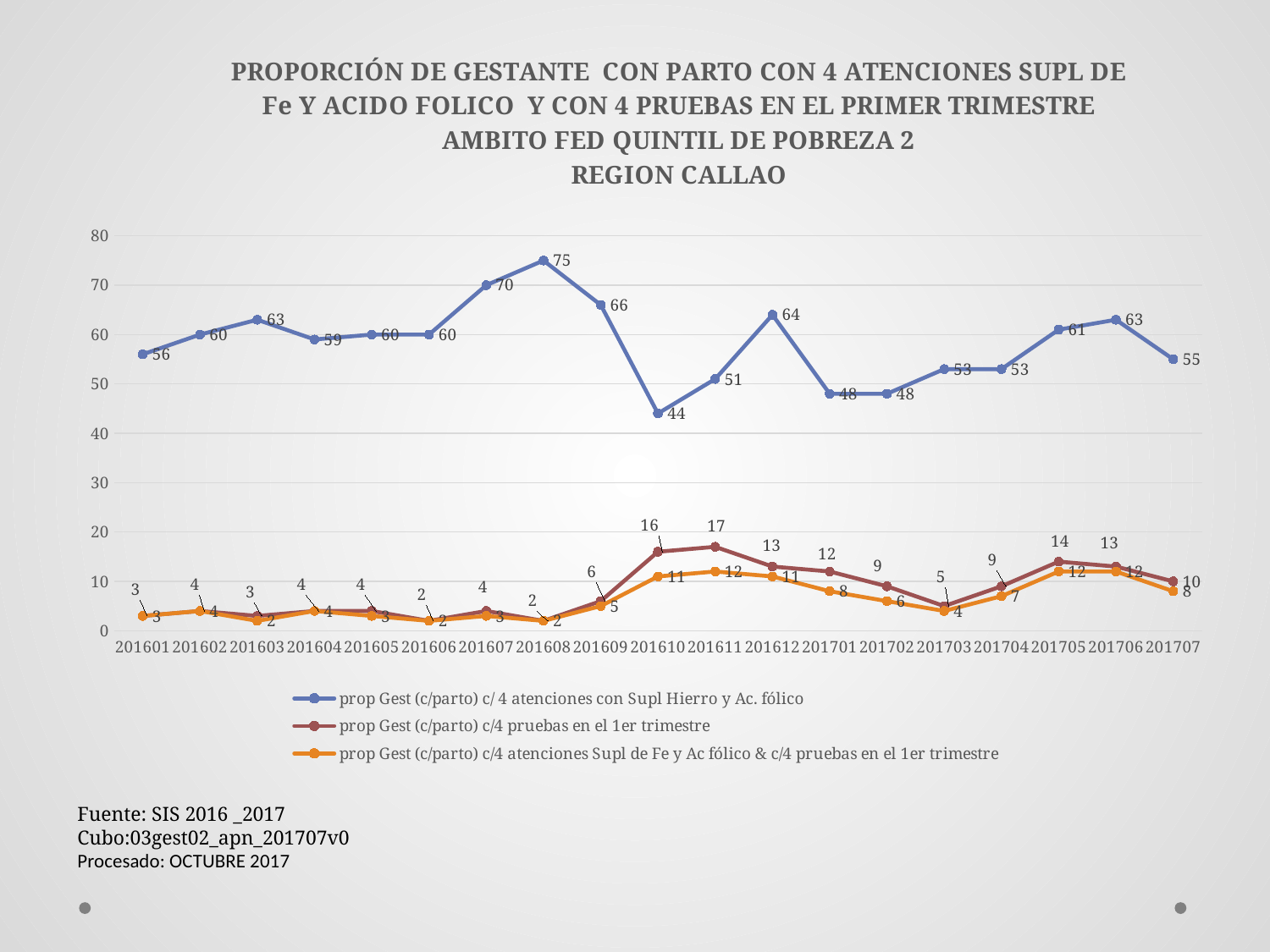
How many periods are shown on the x axis of the chart? 19 What is the difference between the 201608 and 201610 values of the 'prop Gest (c/parto) c/ 4 atenciones con Supl Hierro y Ac. fólico' series? 31 What is the value of the 'prop Gest (c/parto) c/4 atenciones Supl de Fe y Ac fólico & c/4 pruebas en el 1er trimestre' series for 201707? 8 In which period does the 'prop Gest (c/parto) c/ 4 atenciones con Supl Hierro y Ac. fólico' series reach its highest value? 201608 What kind of chart is shown on the slide? Line chart For the 'prop Gest (c/parto) c/ 4 atenciones con Supl Hierro y Ac. fólico' series, which period has the larger value, 201612 or 201701? 201612 What is the value of the 'prop Gest (c/parto) c/ 4 atenciones con Supl Hierro y Ac. fólico' series for 201608? 75 What is the value of the 'prop Gest (c/parto) c/4 pruebas en el 1er trimestre' series for 201611? 17 How many series does the legend list? 3 Is the 201607 value of the 'prop Gest (c/parto) c/ 4 atenciones con Supl Hierro y Ac. fólico' series greater or less than 60? greater In which period does the 'prop Gest (c/parto) c/4 pruebas en el 1er trimestre' series reach its highest value? 201611 In which period does the 'prop Gest (c/parto) c/ 4 atenciones con Supl Hierro y Ac. fólico' series reach its lowest value? 201610